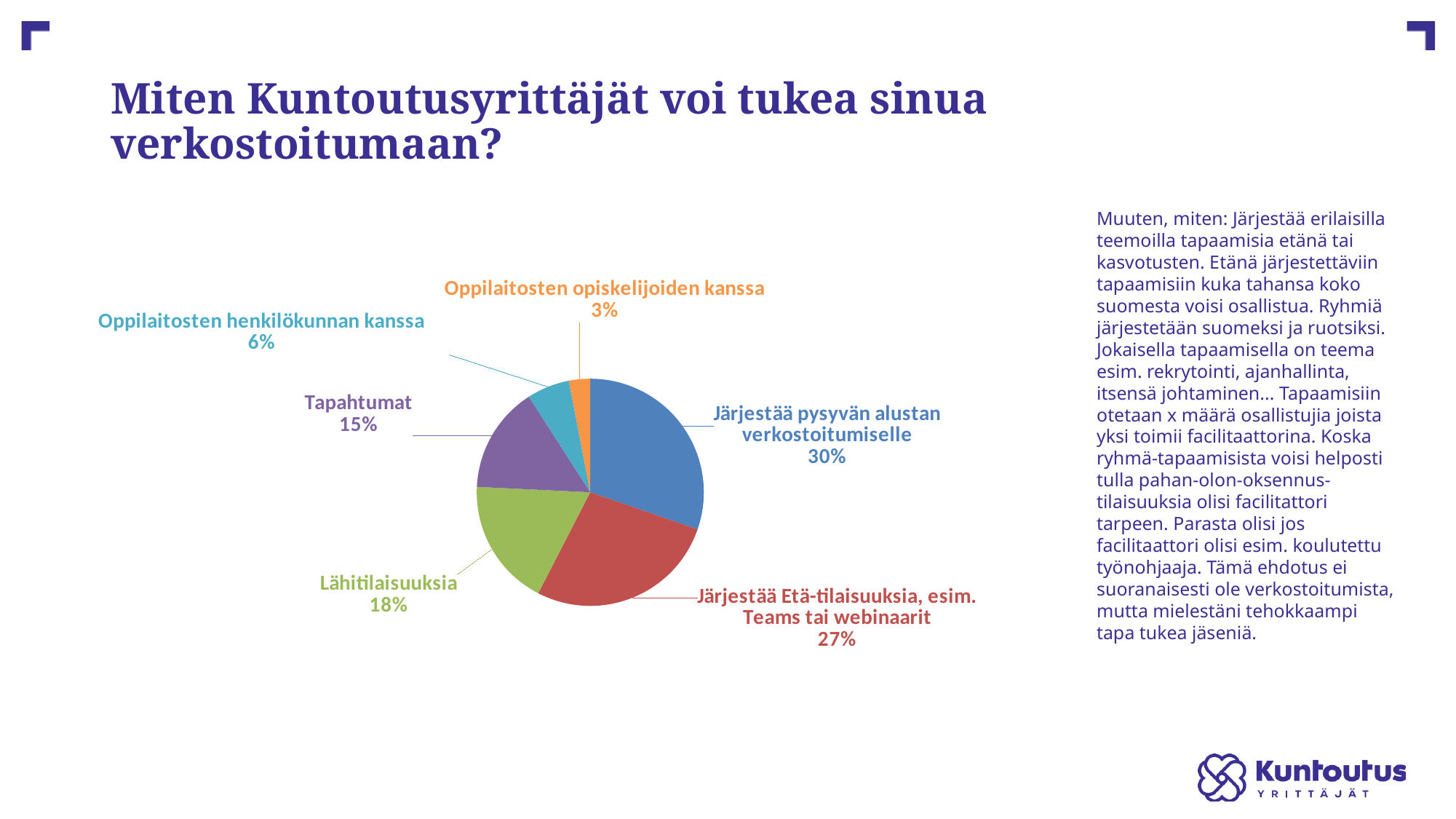
What kind of chart is shown on the slide? Pie chart What is the value for "Tapahtumat"? 15% What is the value for "Järjestää Etä-tilaisuuksia, esim. Teams tai webinaarit"? 27% Which is larger: the share for "Lähitilaisuuksia" or the share for "Tapahtumat"? Lähitilaisuuksia How many categories are shown in the pie chart? 6 Which category has the largest slice of the pie? Järjestää pysyvän alustan verkostoitumiselle What is the value for "Lähitilaisuuksia"? 18% What is the value for "Oppilaitosten henkilökunnan kanssa"? 6% What share of the pie does "Järjestää pysyvän alustan verkostoitumiselle" have? 30% What is the difference between the shares of "Järjestää pysyvän alustan verkostoitumiselle" and "Järjestää Etä-tilaisuuksia, esim. Teams tai webinaarit"? 3% What colour is the slice for "Oppilaitosten opiskelijoiden kanssa"? Orange Which category has the smallest slice of the pie? Oppilaitosten opiskelijoiden kanssa